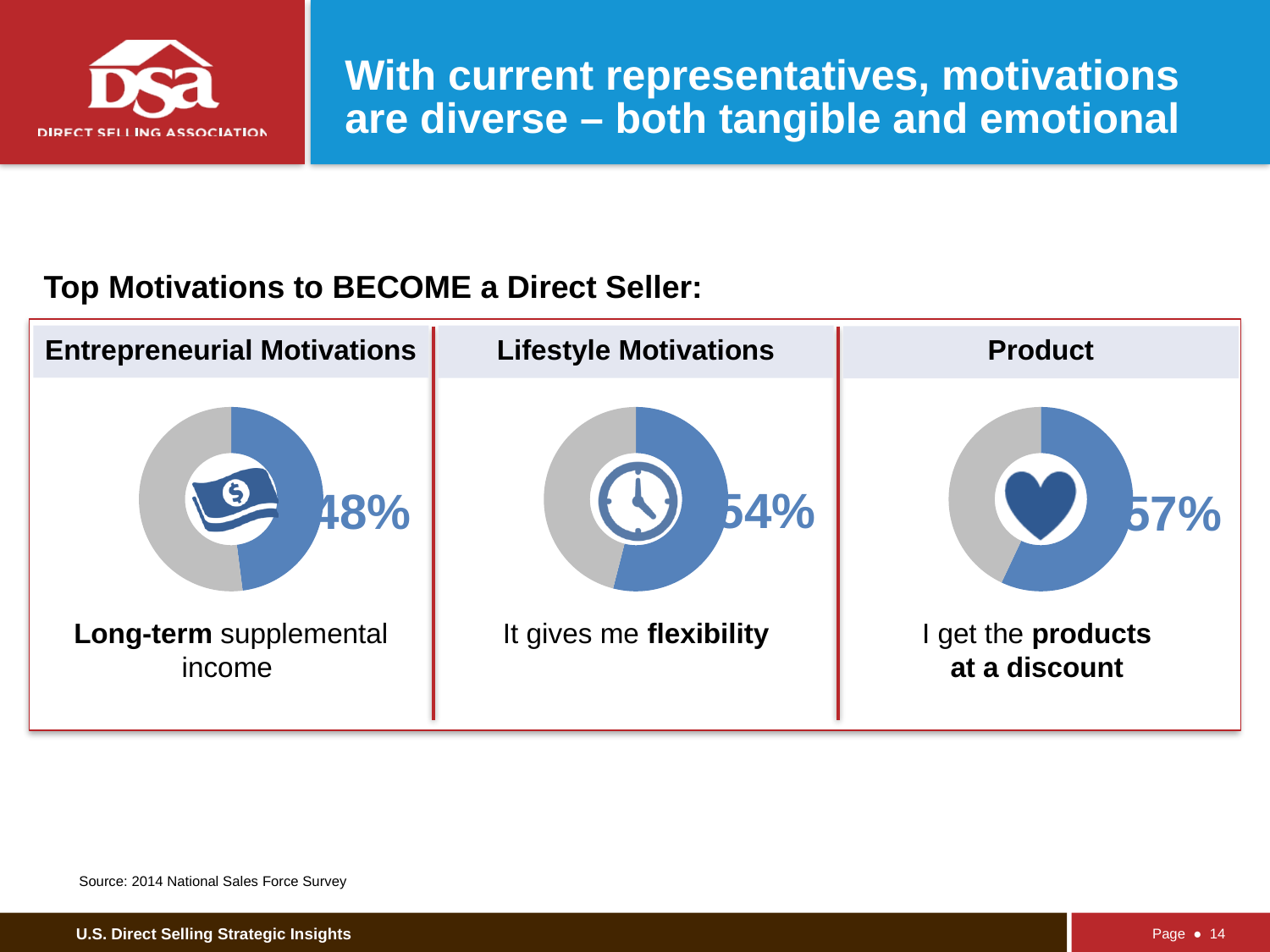
What percentage is shown in the Entrepreneurial Motivations donut chart? 48% How many donut charts are shown on the slide? 3 What percentage is shown in the Product donut chart? 57% What kind of chart is used to show each motivation percentage on the slide? Donut chart What is the difference between the Lifestyle Motivations percentage and the Entrepreneurial Motivations percentage? 6% Which of the three motivation charts shows the lowest percentage? Entrepreneurial Motivations Which is larger: the Lifestyle Motivations percentage or the Product percentage? Product What motivation is described under the Lifestyle Motivations chart? It gives me flexibility What motivation is described under the Product chart? I get the products at a discount What is the difference between the Product percentage and the Entrepreneurial Motivations percentage? 9% Which of the three motivation charts shows the highest percentage? Product What percentage is shown in the Lifestyle Motivations donut chart? 54%